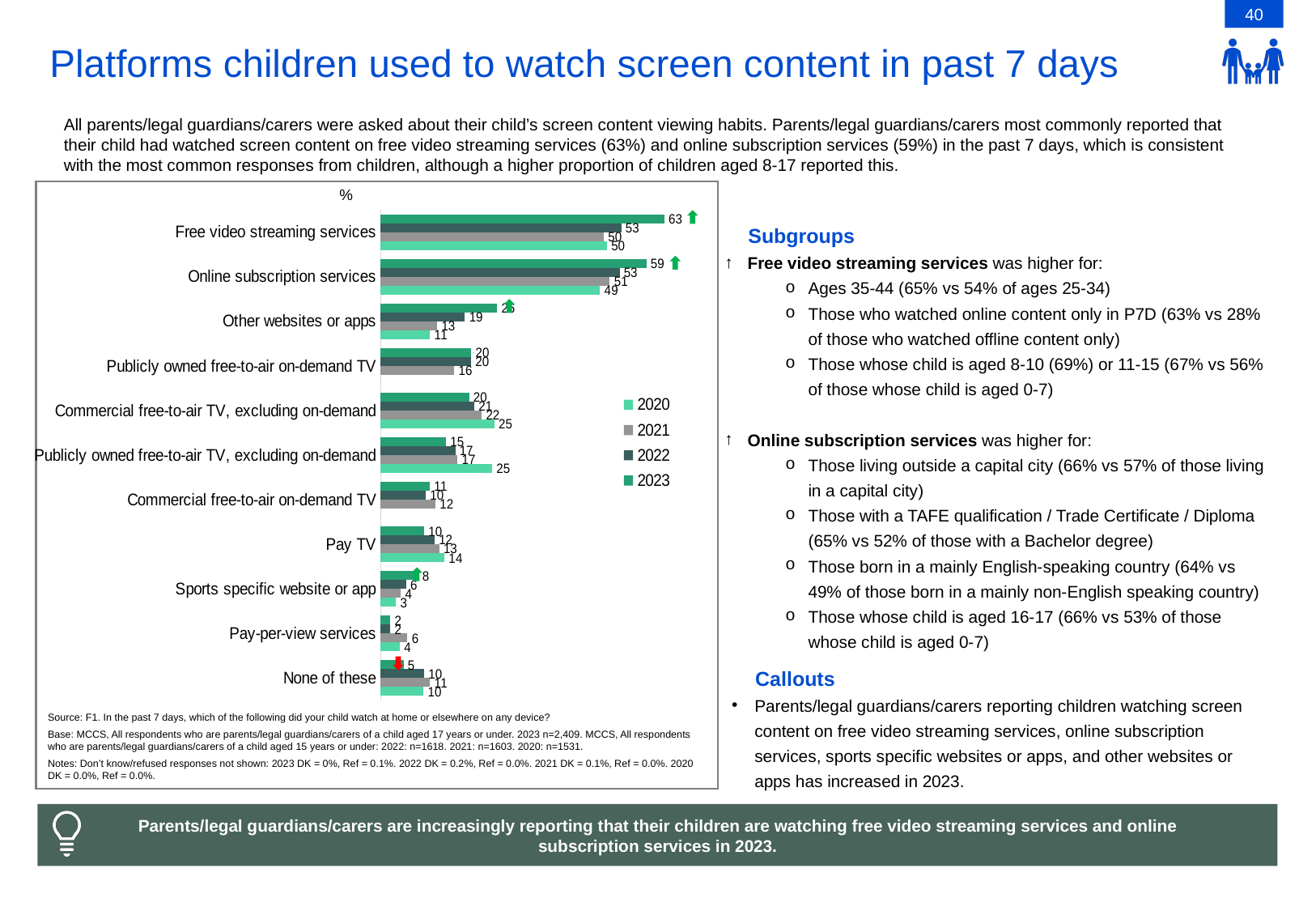
Which category has the lowest 2023 value? Pay-per-view services Do the values for Sports specific website or app rise or fall from 2020 to 2023? Rise How many series does the chart legend list? 4 What is the difference between the 2023 and 2022 values for Free video streaming services? 10 Which is larger for Pay TV: the 2020 value or the 2023 value? 2020 What is the 2023 value for None of these? 5 What kind of chart is shown on the slide? Bar chart What is the 2023 value for Free video streaming services? 63 What is the 2023 value for Online subscription services? 59 How many platform categories are shown on the chart? 11 Which category has the highest 2023 value? Free video streaming services What is the 2020 value for Publicly owned free-to-air TV, excluding on-demand? 25